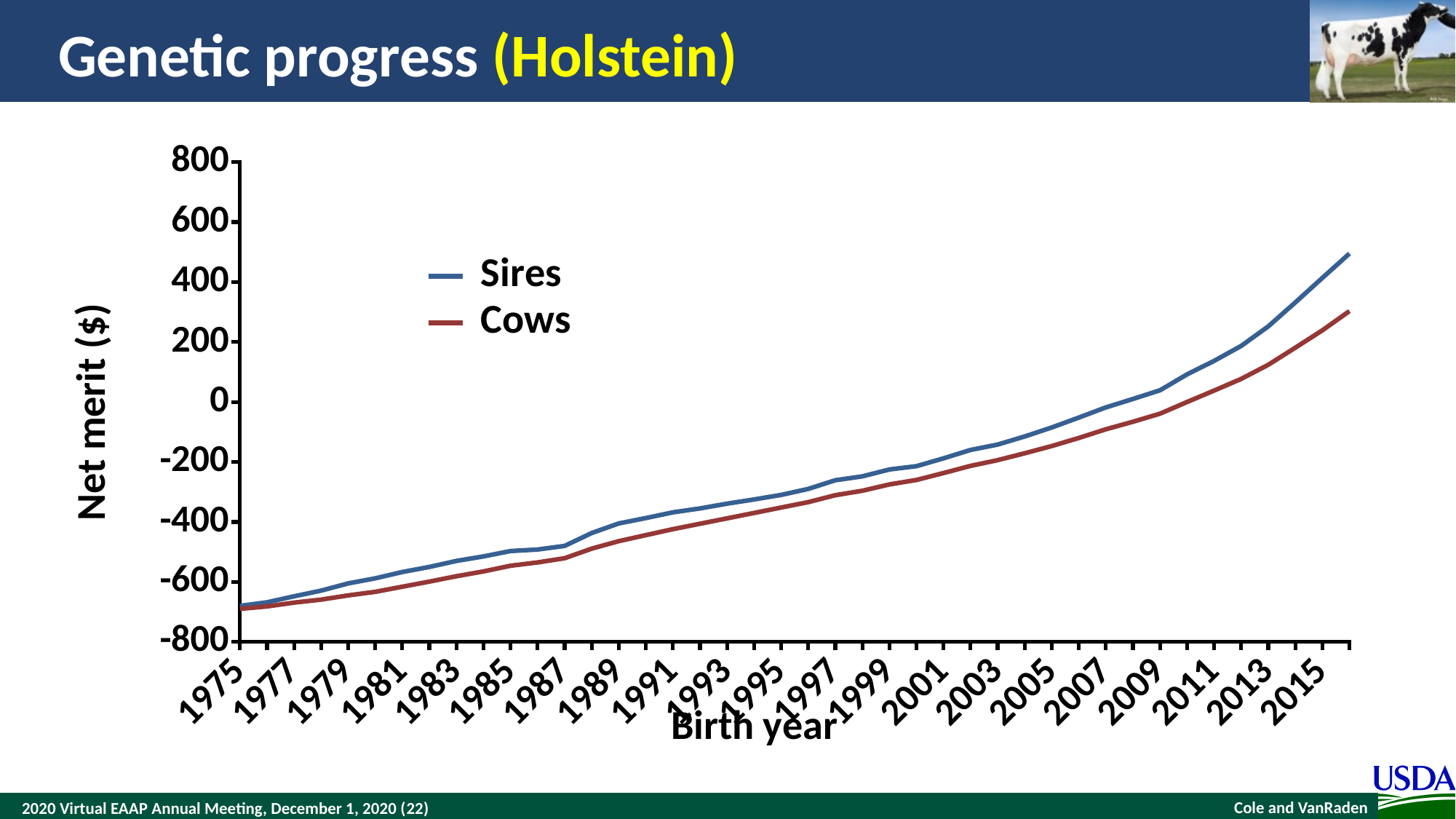
Do the Cows values rise or fall as birth year increases? rise What kind of chart is shown on the slide? line chart Is the Sires value for birth year 1975 greater or less than -600? less Which series has the larger net merit for birth year 2005, Sires or Cows? Sires Is the Cows value for birth year 2001 greater or less than -200? less How many birth-year labels are printed along the x axis? 21 Is the Sires value for birth year 2013 greater or less than 200? greater Which series has the larger net merit for birth year 2015, Sires or Cows? Sires What is the label of the y axis? Net merit ($) How many series does the legend list? 2 Do the Sires values rise or fall as birth year increases? rise